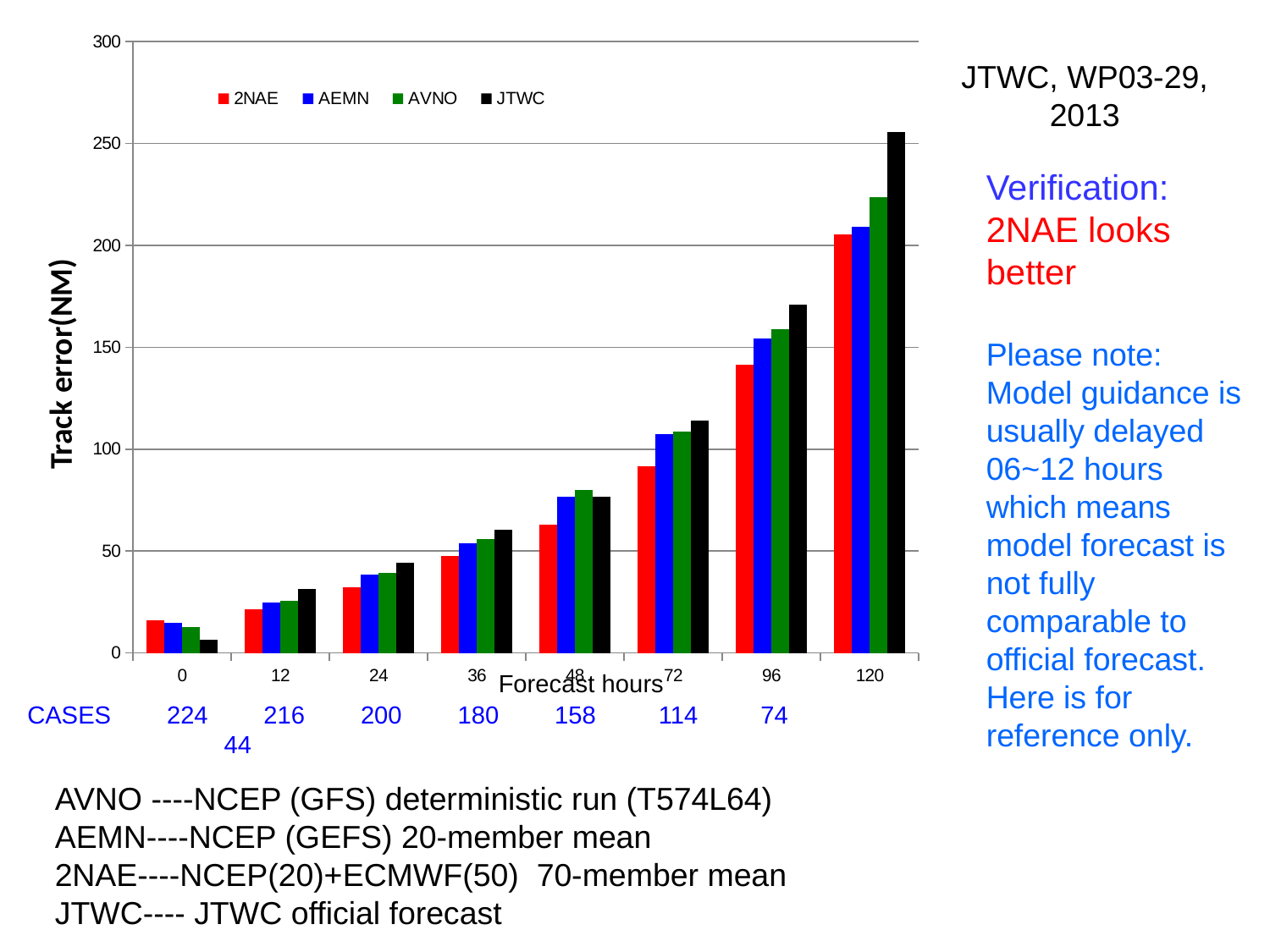
What is the title of the y axis? Track error(NM) Is the track error for AVNO at 120 forecast hours greater or less than 200? greater How many forecast-hour categories are plotted on the x axis? 8 Does the JTWC track error rise or fall as forecast hours increase? rise At 96 forecast hours, which series has the lowest track error? 2NAE How many series does the legend list? 4 At 0 forecast hours, which is larger: the track error for 2NAE or for JTWC? 2NAE Is the track error for JTWC at 72 forecast hours greater or less than 100? greater At 120 forecast hours, which series has the highest track error? JTWC What kind of chart is shown on the slide? bar chart Is the track error for 2NAE at 96 forecast hours greater or less than 150? less At 0 forecast hours, which series has the lowest track error? JTWC